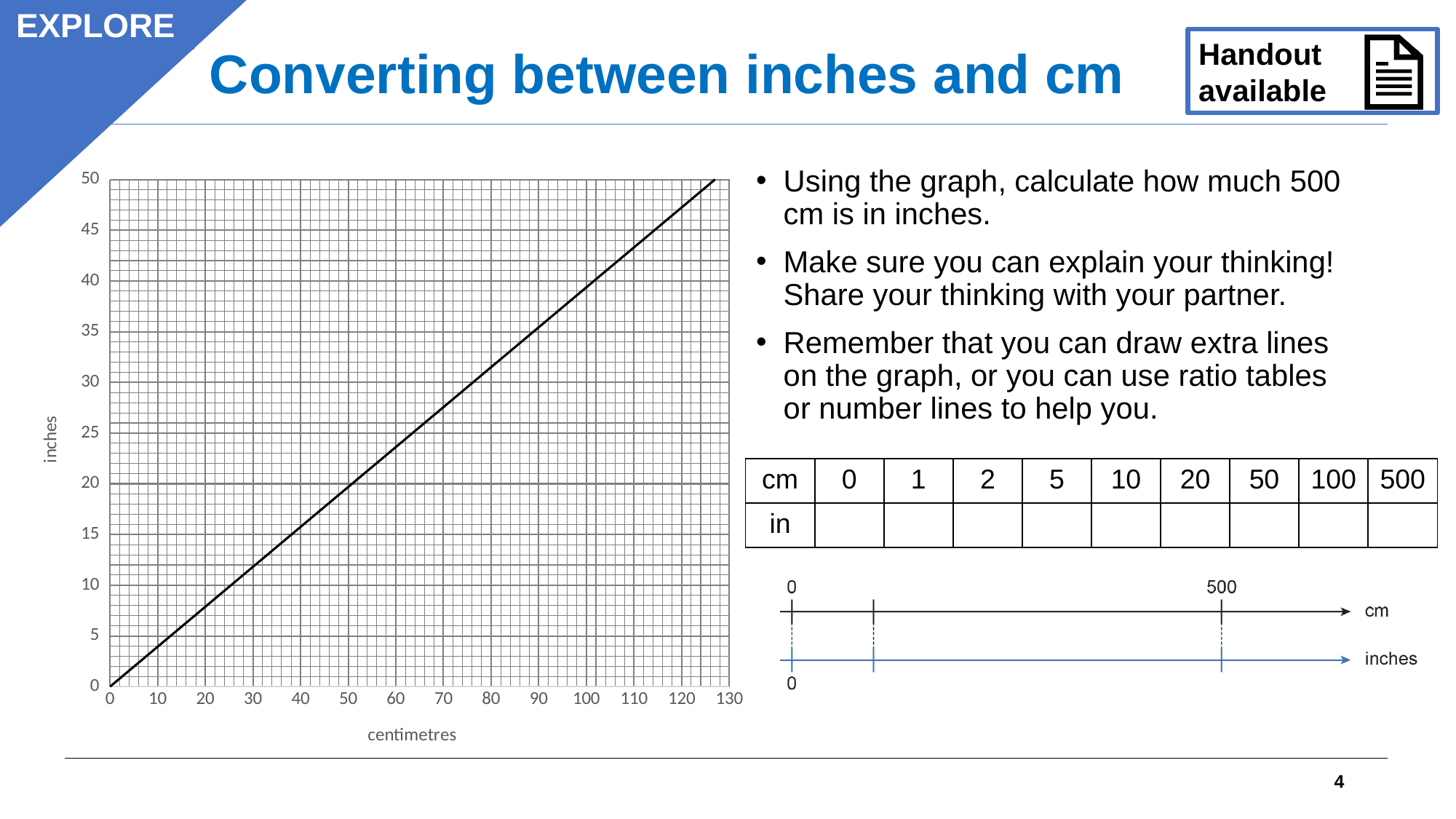
Is the value in inches for 30 centimetres greater or less than 15? less What is the label of the horizontal axis of the graph? centimetres How many lines are plotted on the graph? 1 Is the value in inches for 10 centimetres greater or less than 5? less Is the value in inches for 120 centimetres greater or less than 45? greater Do the values on the graph rise or fall as centimetres increase along the x axis? rise What is the label of the vertical axis of the graph? inches What kind of chart is shown on the slide? line chart